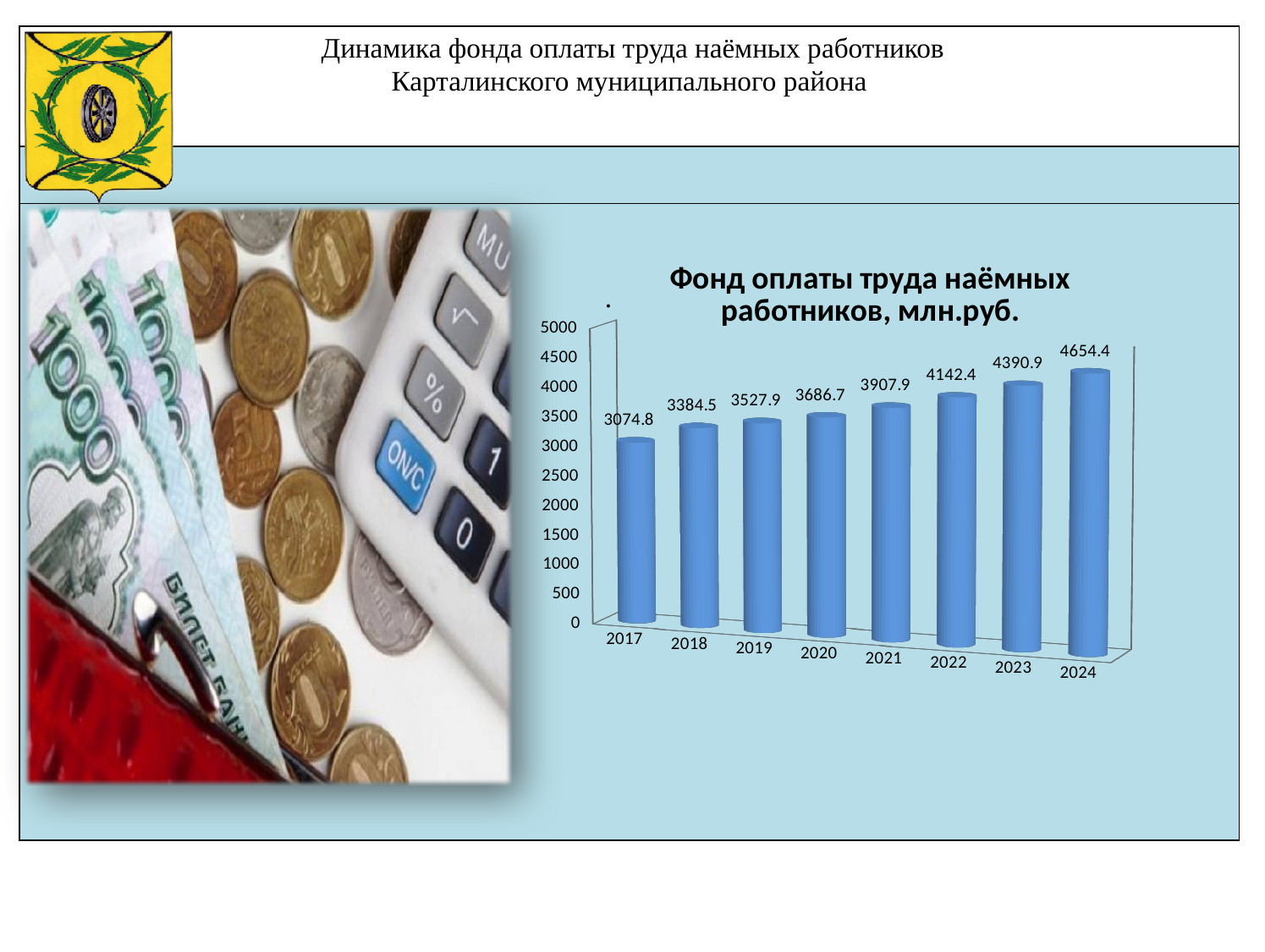
What is the value for 2021? 3907.9 What is the difference between the values for 2023 and 2022? 248.5 What is the value for 2017? 3074.8 What kind of chart is shown? bar chart Which year has the highest value? 2024 What is the difference between the values for 2024 and 2017? 1579.6 What is the value for 2024? 4654.4 Which is larger, the value for 2019 or the value for 2020? 2020 How many years are shown on the x axis? 8 Do the values rise or fall from 2017 to 2024? rise Which year has the lowest value? 2017 Is the value for 2022 greater or less than 4000? greater